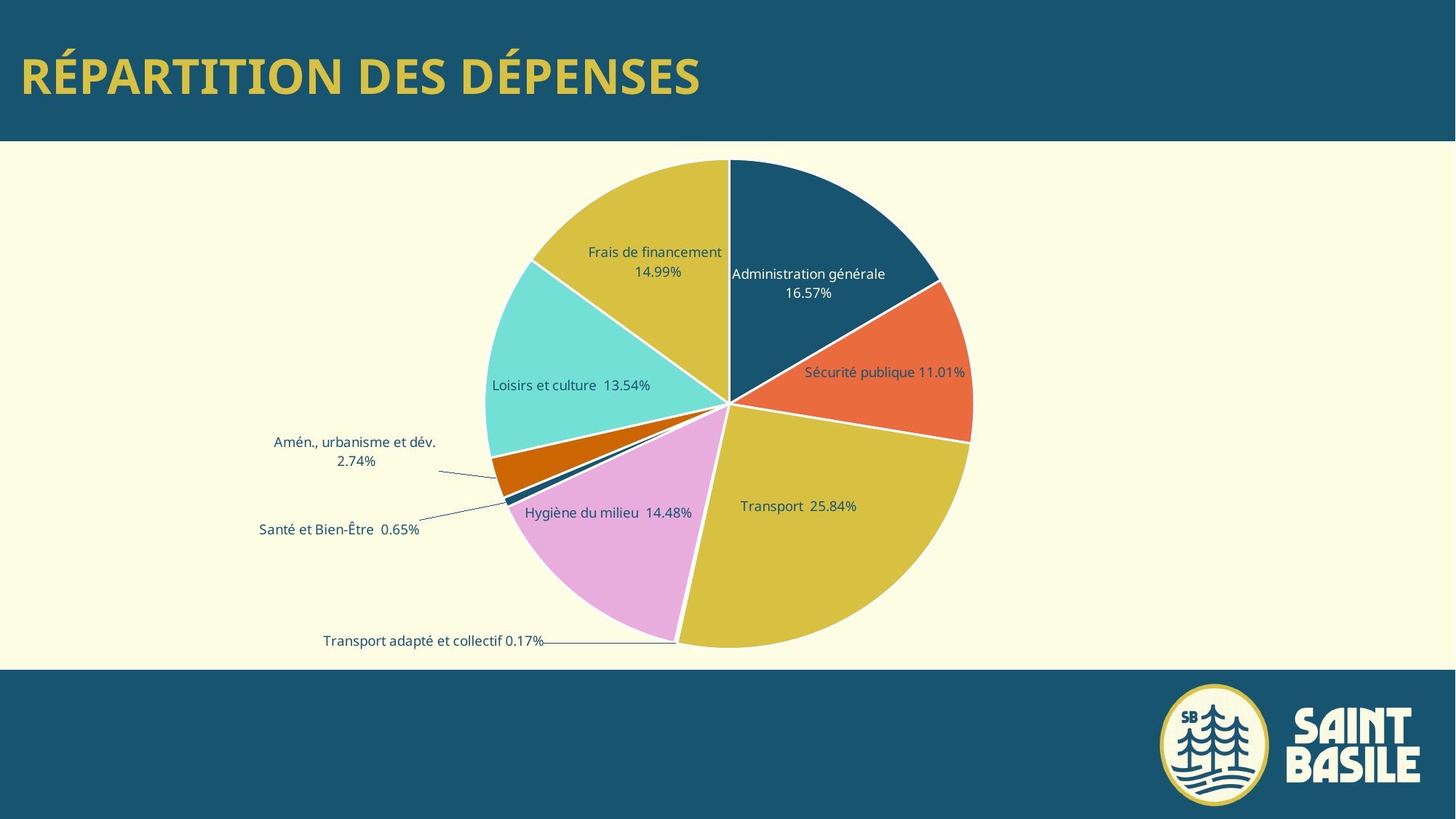
What share of expenses goes to Transport? 25.84% What is the difference between Sécurité publique and Amén., urbanisme et dév.? 8.27% What type of chart is shown on the slide? pie chart How many categories are shown in the pie chart? 9 What percentage is shown for Frais de financement? 14.99% What is the value for Santé et Bien-Être? 0.65% What is the difference between the shares of Transport and Administration générale? 9.27% What is the value for Administration générale? 16.57% Which is larger, Loisirs et culture or Hygiène du milieu? Hygiène du milieu What is the title of the slide containing the chart? RÉPARTITION DES DÉPENSES Which category has the smallest share of expenses? Transport adapté et collectif Which category has the largest share of expenses? Transport